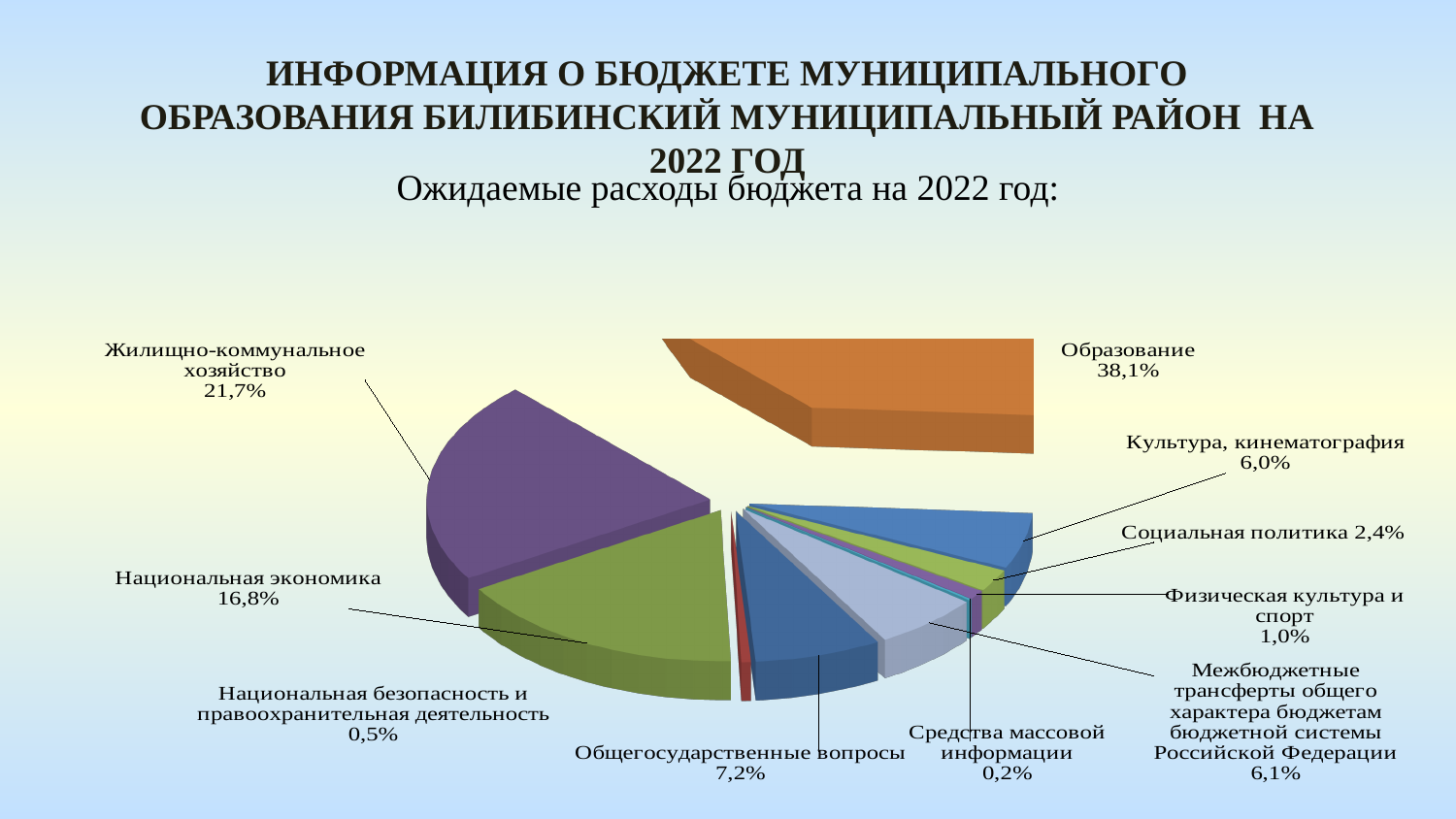
What is the combined share of Физическая культура и спорт and Средства массовой информации? 1,2% What percentage is labelled for Общегосударственные вопросы? 7,2% What percentage is shown for Жилищно-коммунальное хозяйство? 21,7% Which is larger: Культура, кинематография or Социальная политика? Культура, кинематография What is the subtitle of the chart on the slide? Ожидаемые расходы бюджета на 2022 год: Which category has the largest share of the pie? Образование How many categories are shown in the pie chart? 10 What is the value for Межбюджетные трансферты общего характера бюджетам бюджетной системы Российской Федерации? 6,1% What share of expected 2022 budget expenditures goes to Образование? 38,1% What is the difference in percentage points between Жилищно-коммунальное хозяйство and Национальная экономика? 4,9 What type of chart is shown on the slide? Pie chart Which category has the smallest share of the pie? Средства массовой информации